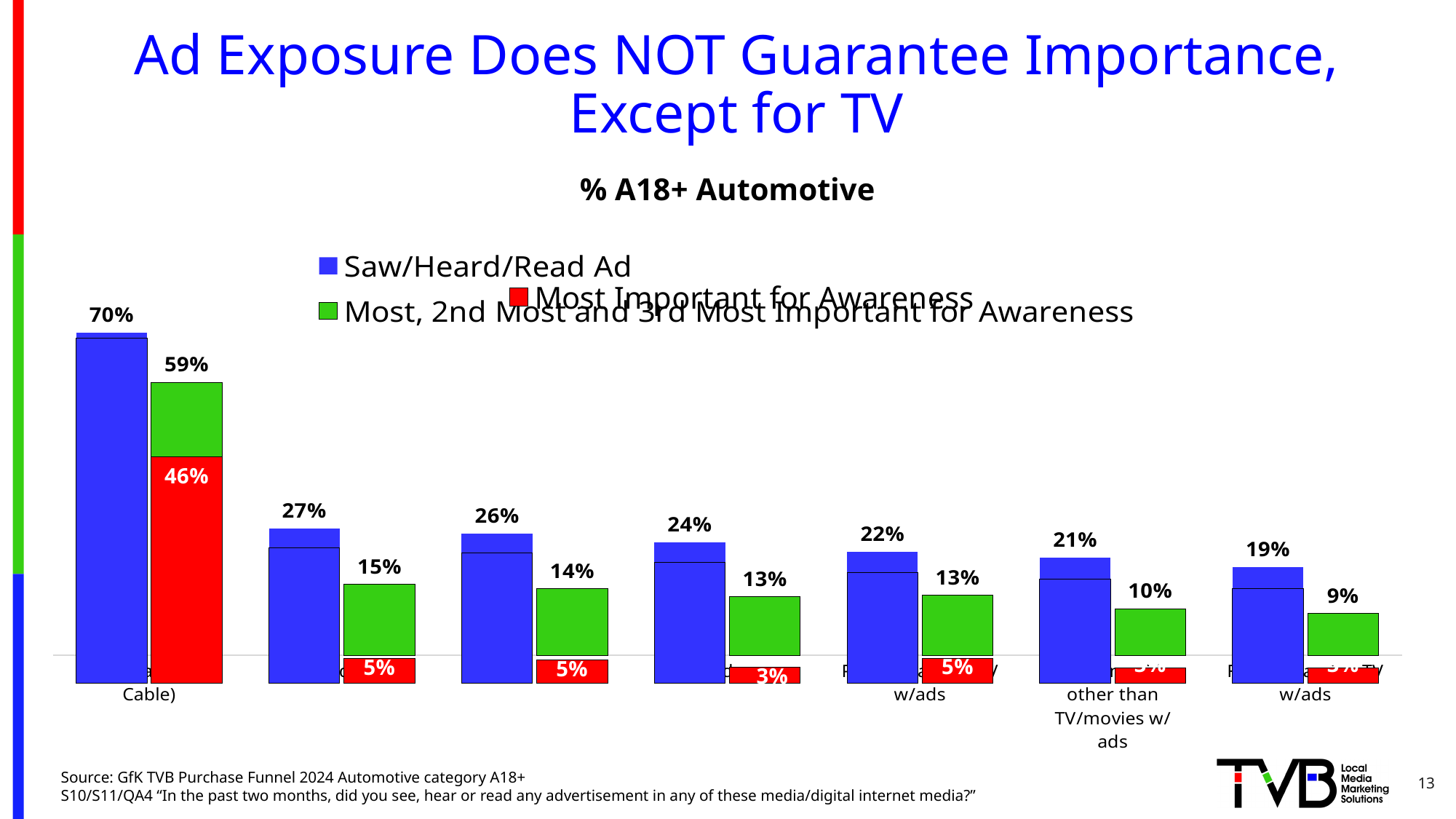
What kind of chart is shown on the slide? bar chart What is the 'Most Important for Awareness' value for the leftmost category group? 46% What is the 'Most, 2nd Most and 3rd Most Important for Awareness' value for the leftmost category group? 59% How many category groups of bars are plotted in the chart? 7 What is the Saw/Heard/Read Ad value for the second category group from the left? 27% How many series does the chart legend list? 3 What is the title printed above the chart? % A18+ Automotive What is the difference between the Saw/Heard/Read Ad value (70%) and the 'Most, 2nd Most and 3rd Most Important for Awareness' value (59%) in the leftmost category group? 11 percentage points What is the lowest Saw/Heard/Read Ad value shown in the chart? 19% Do the Saw/Heard/Read Ad values rise or fall moving from left to right across the chart? fall What is the Saw/Heard/Read Ad value for the leftmost category group? 70% Which category group has the highest Saw/Heard/Read Ad value? the leftmost group